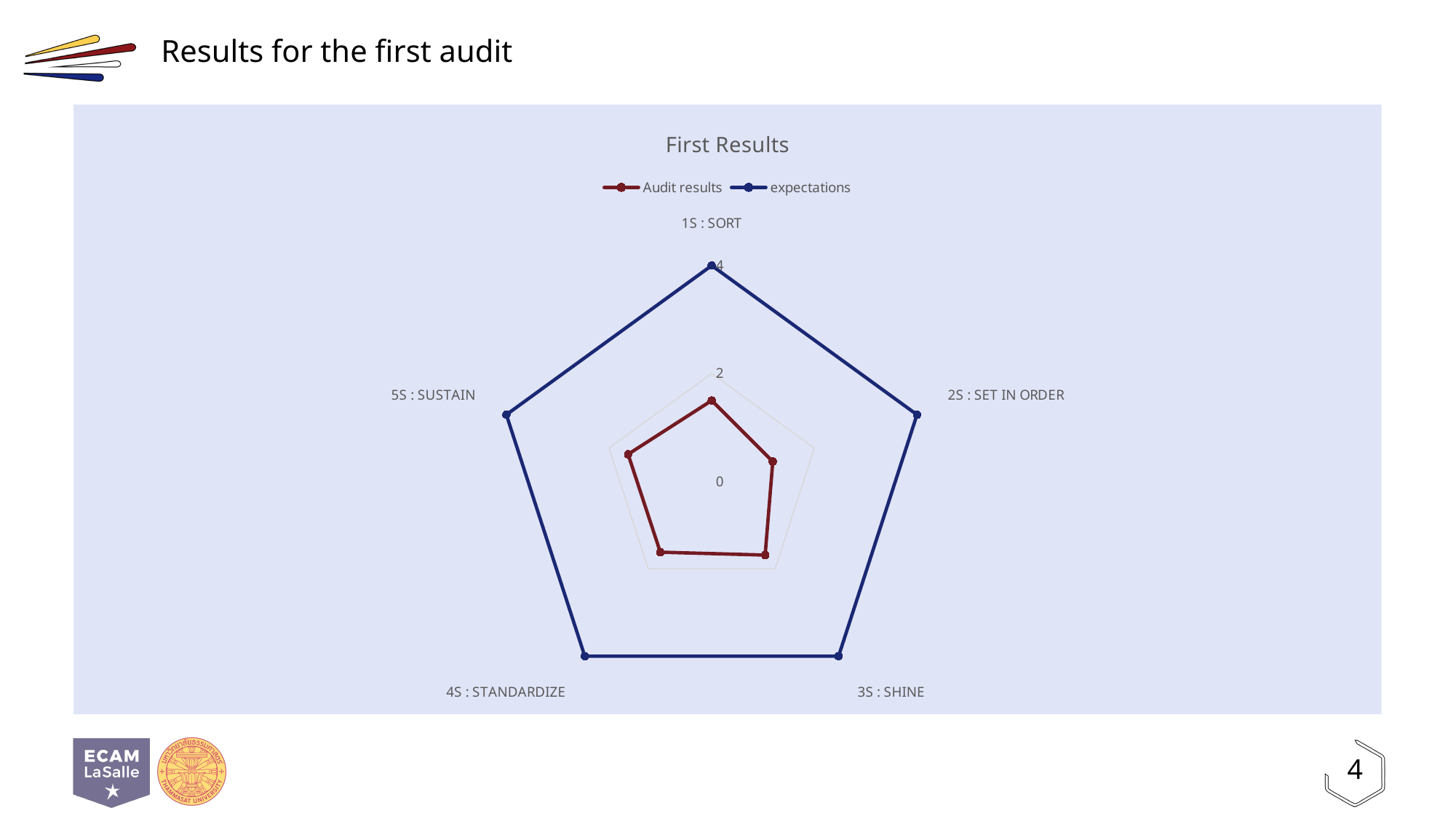
How many series does the chart legend list? 2 What is the title of the chart? First Results Is the Audit results value for 1S : SORT greater or less than 2? less What is the highest value shown on the chart's axis scale? 4 What kind of chart is shown on the slide? Radar chart Which series is drawn in dark red? Audit results For 2S : SET IN ORDER, which series has the larger value, Audit results or expectations? expectations What is the expectations value for 1S : SORT? 4 For 5S : SUSTAIN, which series has the smaller value, Audit results or expectations? Audit results Is the Audit results value for 3S : SHINE greater or less than 2? less How many categories (axes) does the radar chart have? 5 Is the expectations value for 4S : STANDARDIZE greater or less than 2? greater